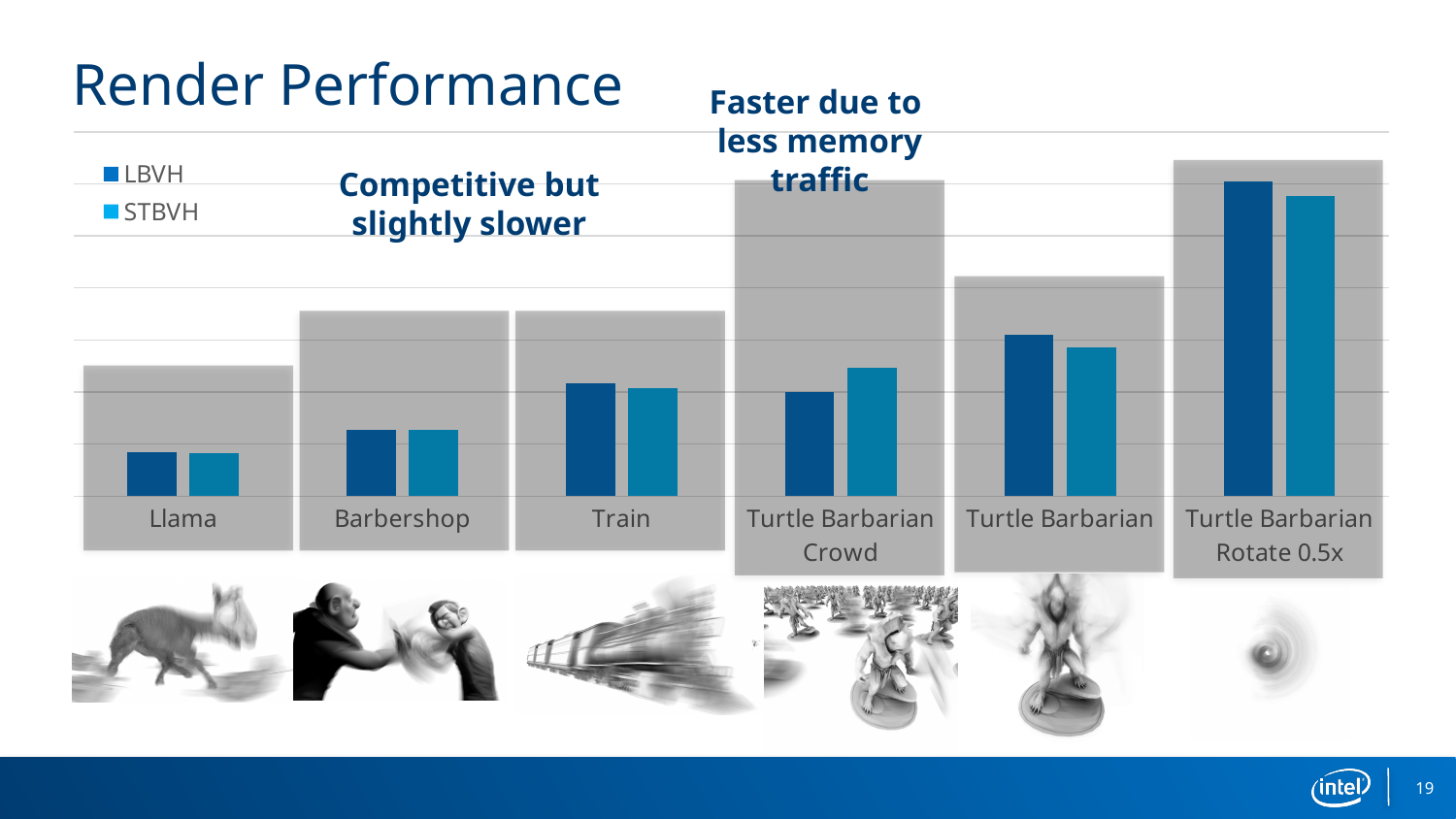
Which category has the highest LBVH bar? Turtle Barbarian Rotate 0.5x For Turtle Barbarian Crowd, which series has the larger bar, LBVH or STBVH? STBVH How many series does the legend list? 2 What is the title of the slide containing the chart? Render Performance Which category has the highest STBVH bar? Turtle Barbarian Rotate 0.5x Which category has the lowest STBVH bar? Llama Which category has the lowest LBVH bar? Llama For Turtle Barbarian, which series has the larger bar, LBVH or STBVH? LBVH Do the bar heights generally rise or fall from left to right along the x axis? Rise What are the two series named in the legend? LBVH and STBVH How many categories are shown on the x axis? 6 What kind of chart is shown on the slide? Bar chart